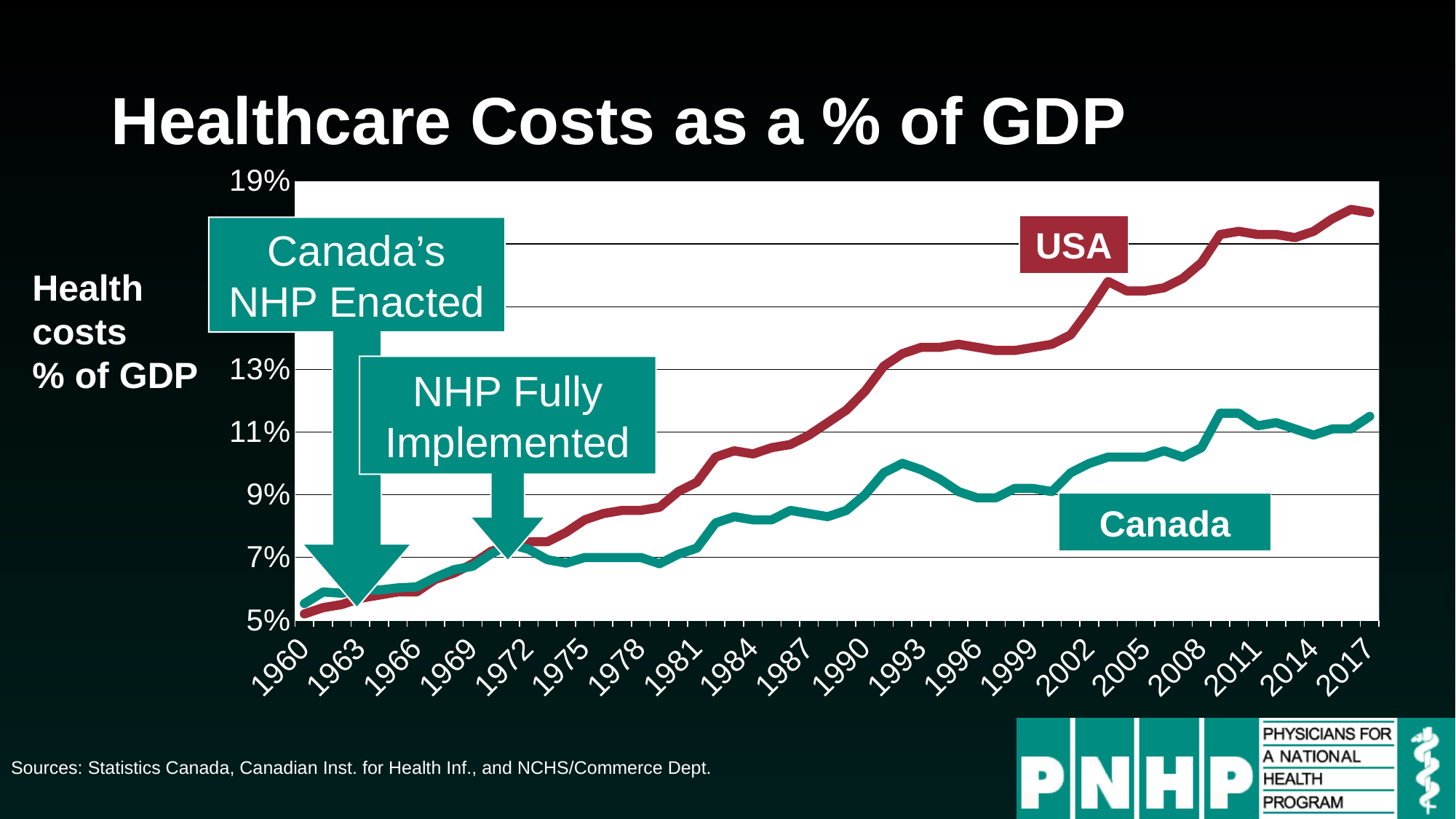
Is the value for USA in 2002 greater or less than 13%? greater Is the value for USA in 1960 greater or less than 7%? less Does the USA series generally rise or fall from 1960 to 2017? rise How many series are plotted on the chart? 2 Is the value for Canada in 2017 greater or less than 13%? less What is the title of the chart? Healthcare Costs as a % of GDP What kind of chart is shown on the slide? line chart Which series is higher in 2017, USA or Canada? USA What label is shown on the vertical axis of the chart? Health costs % of GDP Which series reaches the highest value on the chart? USA